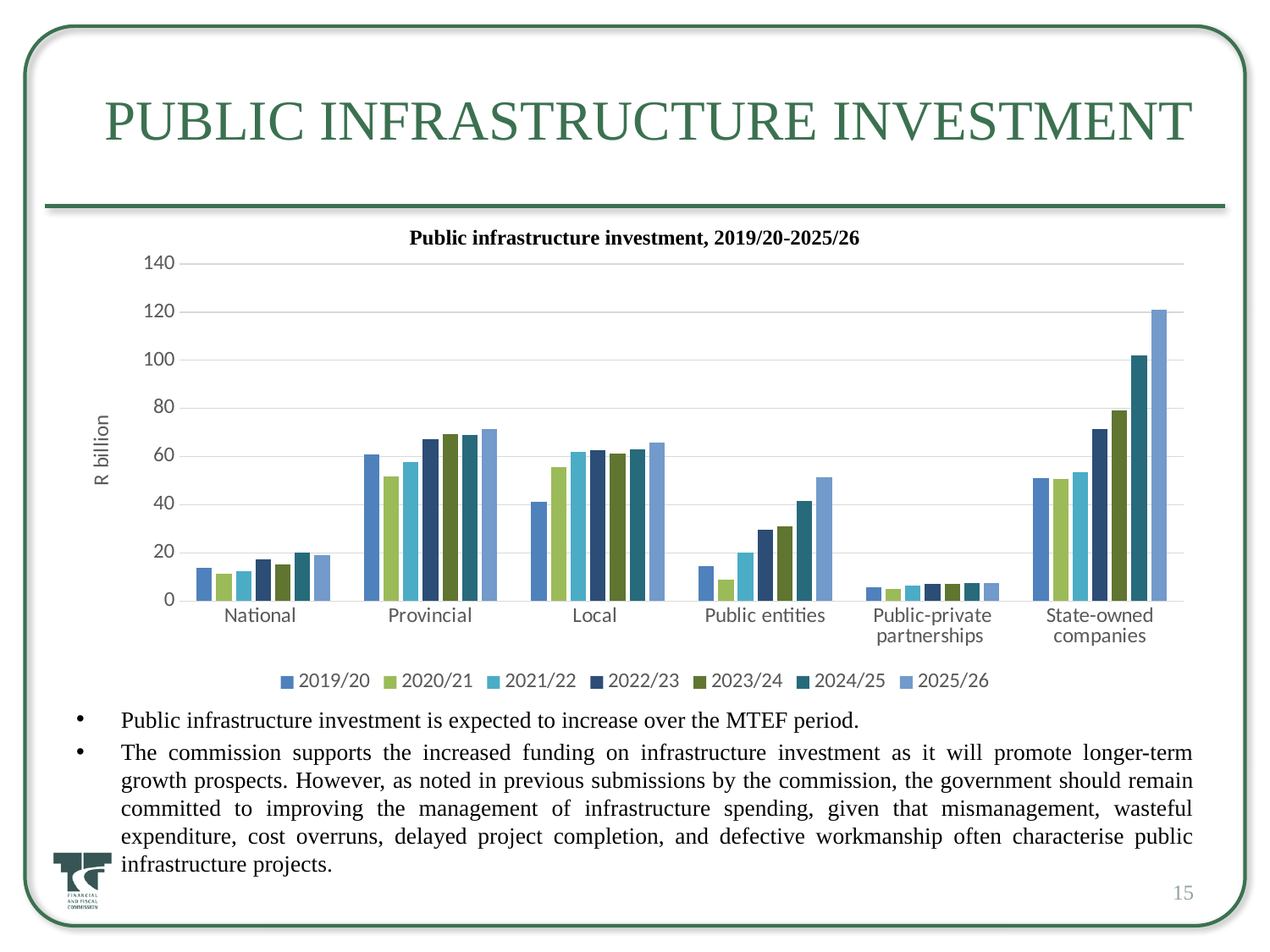
What is the label on the y axis? R billion Is the value for State-owned companies in 2025/26 greater or less than 100? greater How many series does the legend list? 7 Which is larger in 2019/20: Local or Provincial? Provincial Do the values for State-owned companies rise or fall from 2019/20 to 2025/26? rise Is the value for Provincial in 2020/21 greater or less than 60? less Which is larger in 2024/25: State-owned companies or Provincial? State-owned companies Which category has the highest value for 2025/26? State-owned companies Is the value for Public entities in 2025/26 greater or less than 40? greater Which category has the lowest value for 2025/26? Public-private partnerships What kind of chart is shown on the slide? bar chart How many categories are shown on the x axis? 6